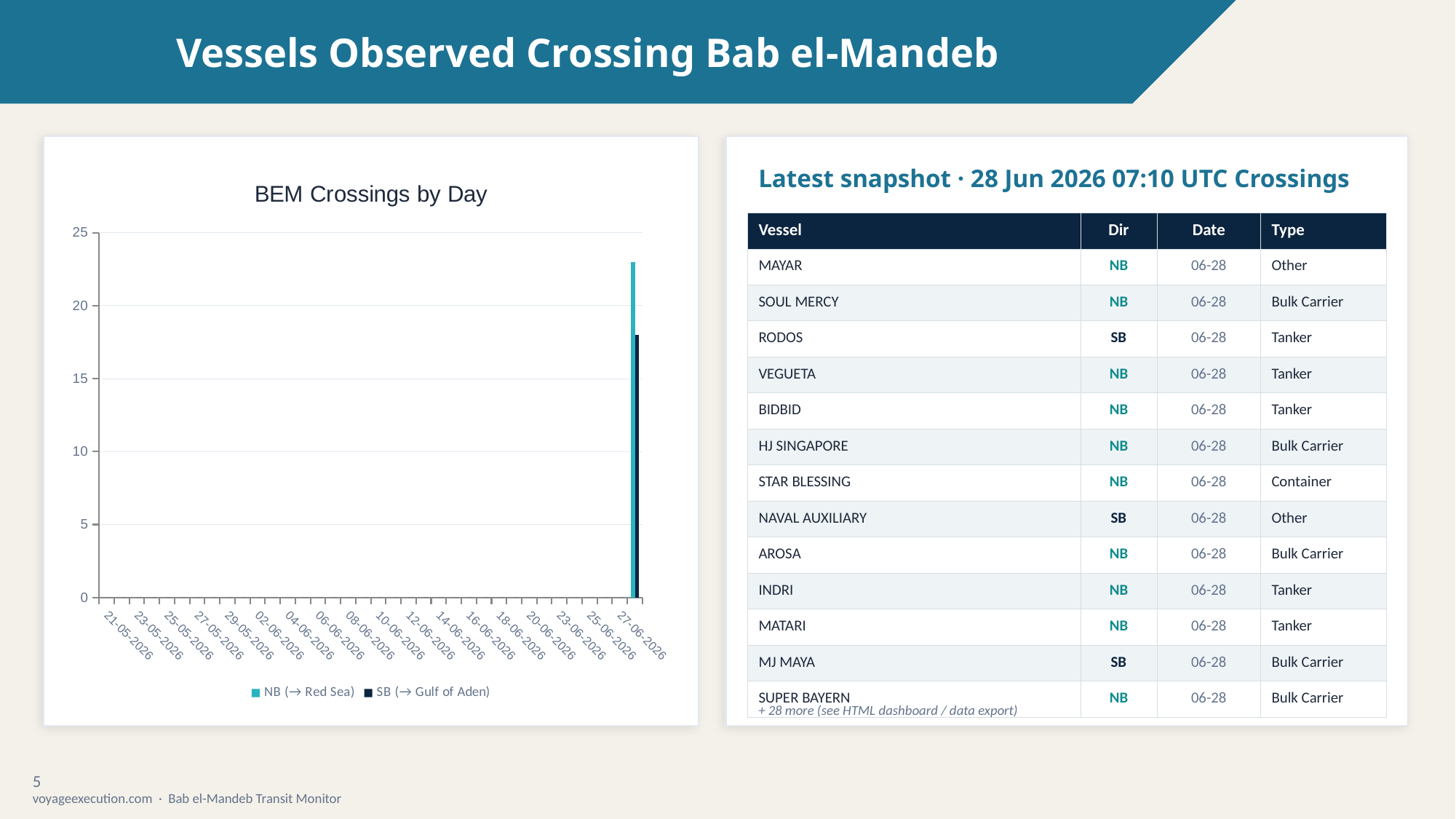
What kind of chart is 'BEM Crossings by Day'? bar chart What is the highest value shown on the y axis of 'BEM Crossings by Day'? 25 What is the title of the chart on the left of the slide? BEM Crossings by Day In 'BEM Crossings by Day', which series has the taller bar on the rightmost date, NB (→ Red Sea) or SB (→ Gulf of Aden)? NB (→ Red Sea) In 'BEM Crossings by Day', is the NB (→ Red Sea) bar on the rightmost date greater or less than 20? greater In 'BEM Crossings by Day', is the SB (→ Gulf of Aden) bar on the rightmost date greater or less than 20? less How many series does the legend of 'BEM Crossings by Day' list? 2 What is the last date label on the x axis of 'BEM Crossings by Day'? 27-06-2026 In 'BEM Crossings by Day', is the NB (→ Red Sea) bar on the rightmost date greater or less than 25? less What are the two legend entries in 'BEM Crossings by Day'? NB (→ Red Sea) and SB (→ Gulf of Aden) What is the first date label on the x axis of 'BEM Crossings by Day'? 21-05-2026